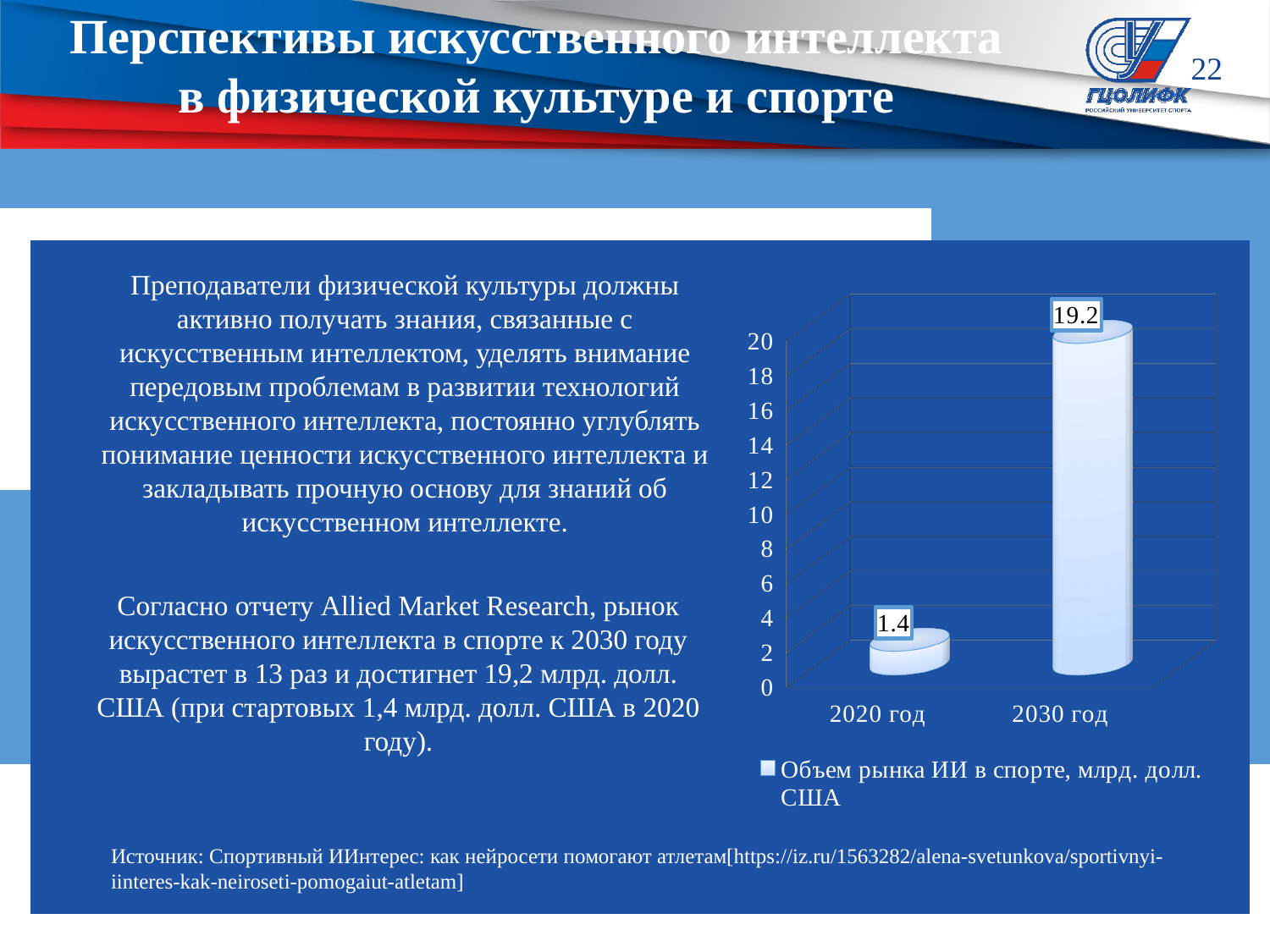
Is the value for 2020 год greater or less than 2? less Which category has the lowest value in the chart? 2020 год What is the legend entry of the series in the chart? Объем рынка ИИ в спорте, млрд. долл. США Which category has the highest value in the chart? 2030 год Is the value for 2030 год greater or less than 18? greater What kind of chart is shown on the slide? bar chart Which is larger: the value for 2020 год or the value for 2030 год? 2030 год What is the value for 2030 год in the chart? 19.2 How many series does the chart legend list? 1 What is the difference between the values for 2030 год and 2020 год? 17.8 What is the value for 2020 год in the chart? 1.4 How many categories are shown on the x axis of the chart? 2